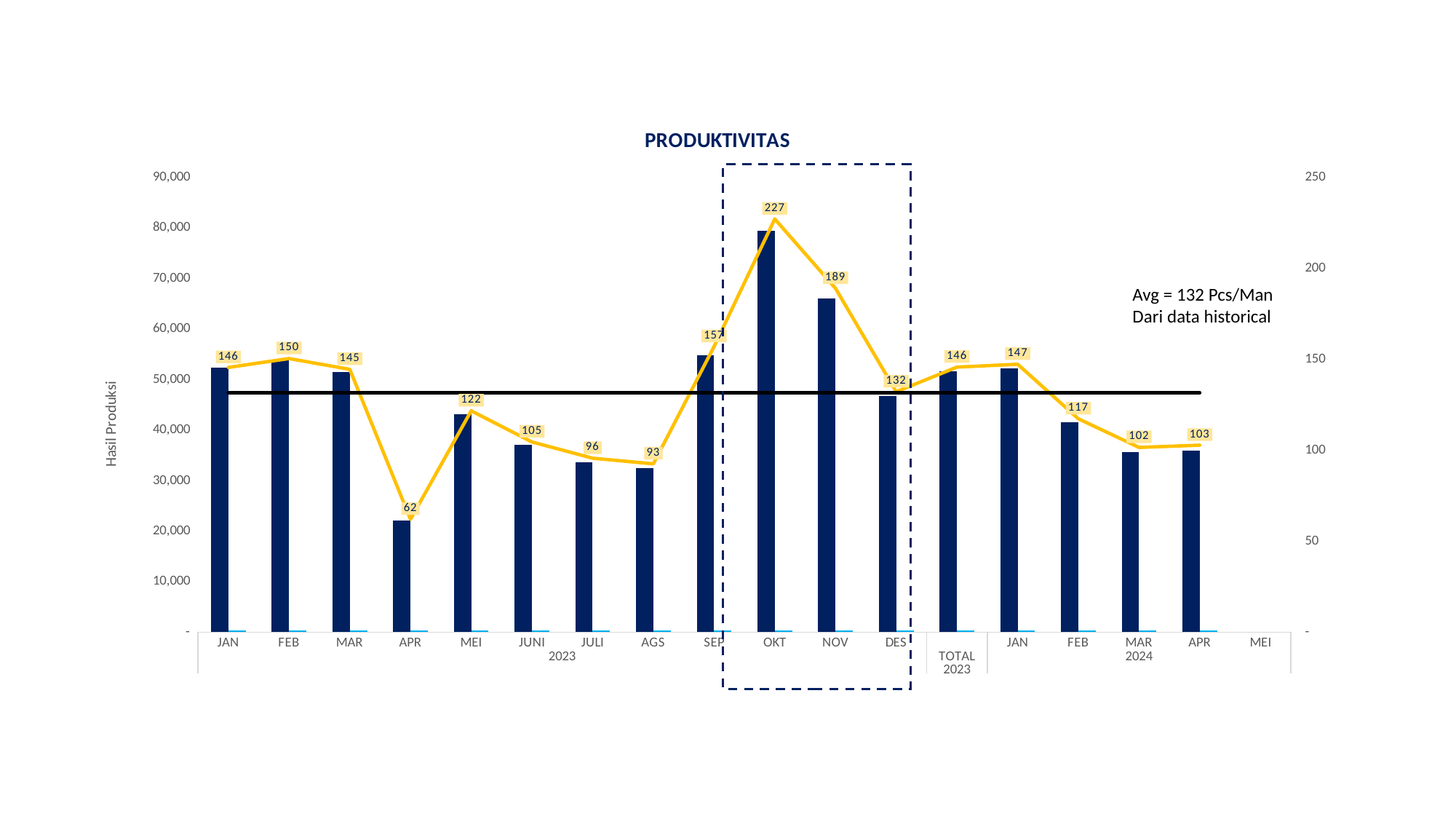
What is the title of the chart? PRODUKTIVITAS Is the Hasil Produksi bar for APR 2023 greater or less than 30,000? less What is the productivity line value labelled for OKT 2023? 227 What is the difference between the productivity line values for OKT 2023 and NOV 2023? 38 What average value is stated in the text annotation on the chart? Avg = 132 Pcs/Man Which month has the highest productivity line value? OKT 2023 Is the Hasil Produksi bar for OKT 2023 greater or less than 70,000? greater Which month has the lowest productivity line value? APR 2023 Which has a larger productivity line value, SEP 2023 or DES 2023? SEP 2023 What is the productivity line value labelled for TOTAL 2023? 146 What is the productivity line value labelled for FEB 2024? 117 What is the productivity line value labelled for APR 2023? 62